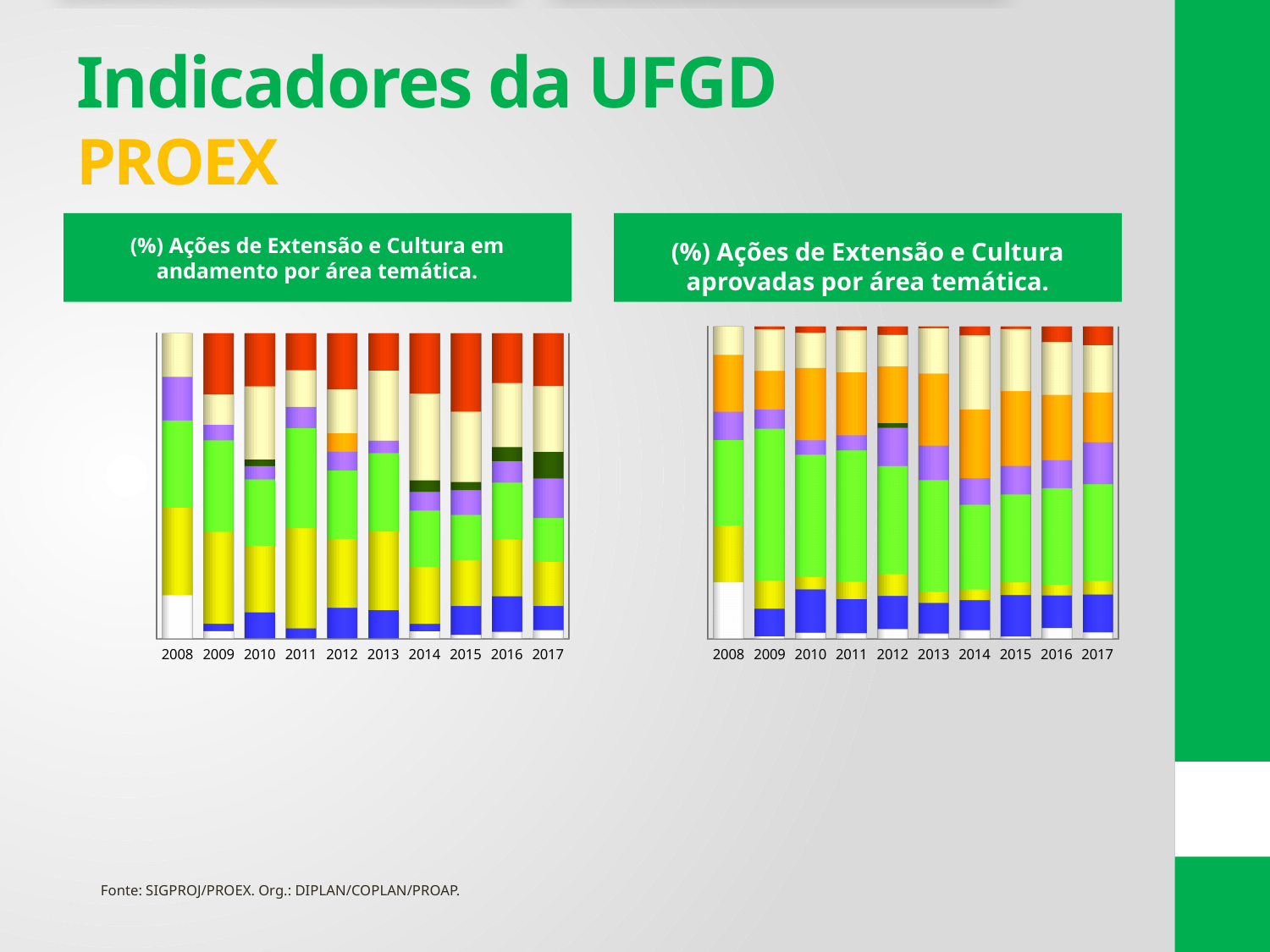
In the right chart, what is the last year shown on the x axis? 2017 What is the title of the chart on the right of the slide? (%) Ações de Extensão e Cultura aprovadas por área temática. In the left chart, "(%) Ações de Extensão e Cultura em andamento por área temática.", how many years are shown on the x axis? 10 In the left chart, what is the first year shown on the x axis? 2008 What kind of chart is the chart titled "(%) Ações de Extensão e Cultura em andamento por área temática."? Stacked bar chart What is the title of the chart on the left of the slide? (%) Ações de Extensão e Cultura em andamento por área temática. In the right chart, "(%) Ações de Extensão e Cultura aprovadas por área temática.", how many bars are plotted? 10 What kind of chart is the chart titled "(%) Ações de Extensão e Cultura aprovadas por área temática."? Stacked bar chart